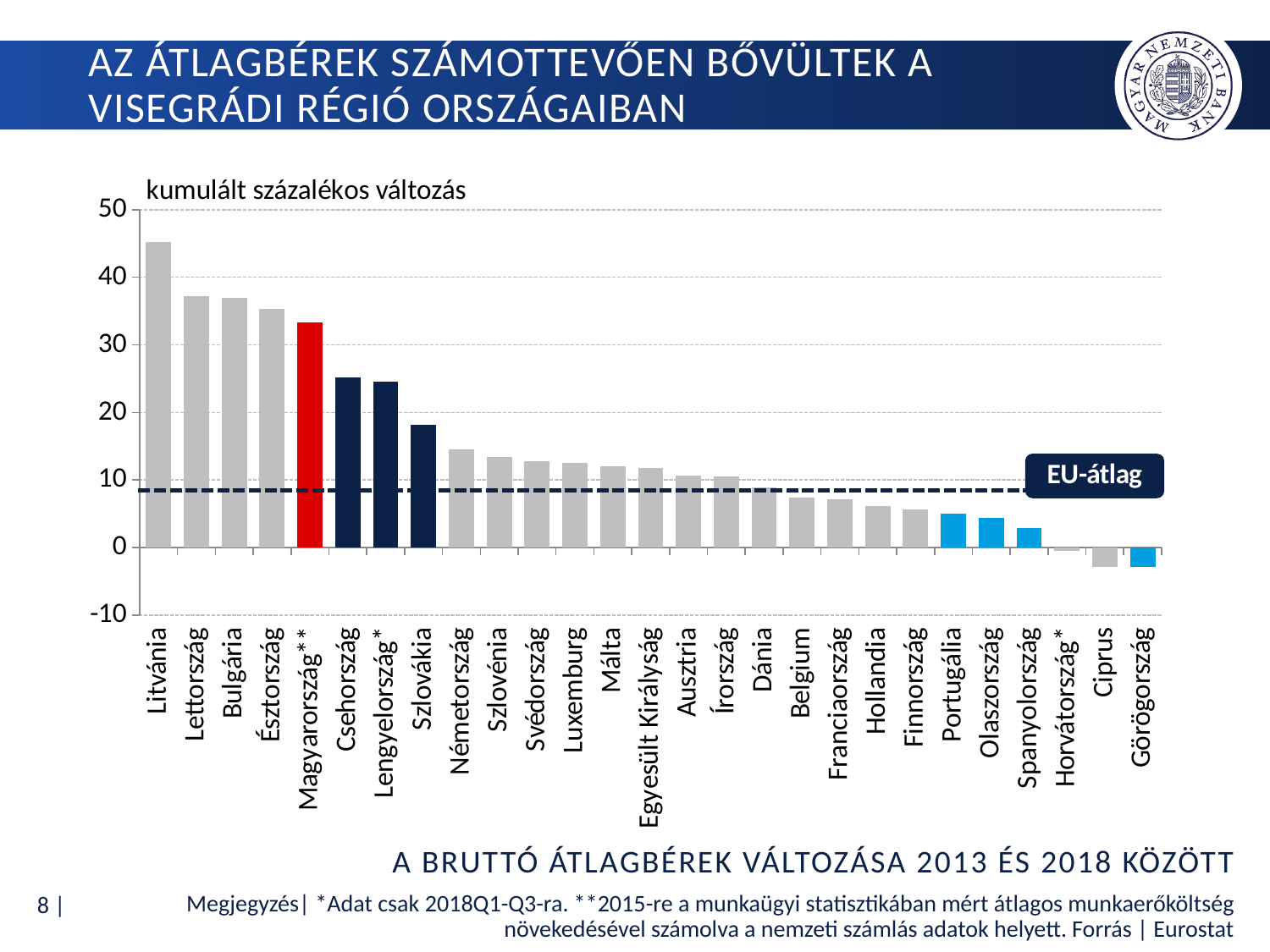
What colour is the bar for Magyarország**? red Is the value for Magyarország** greater or less than 30? greater Which is larger, the value for Magyarország** or the value for Csehország? Magyarország** Is the value for Szlovákia greater or less than 20? less What does the label on the dashed horizontal line say? EU-átlag Which country has the highest cumulative percentage change in the chart? Litvánia Do the bar values rise or fall moving from left to right along the x axis? fall How many countries are shown on the x axis of the chart? 27 Is the value for Portugália greater or less than 10? less What kind of chart is shown on the slide? bar chart Which is larger, the value for Szlovákia or the value for Németország? Szlovákia